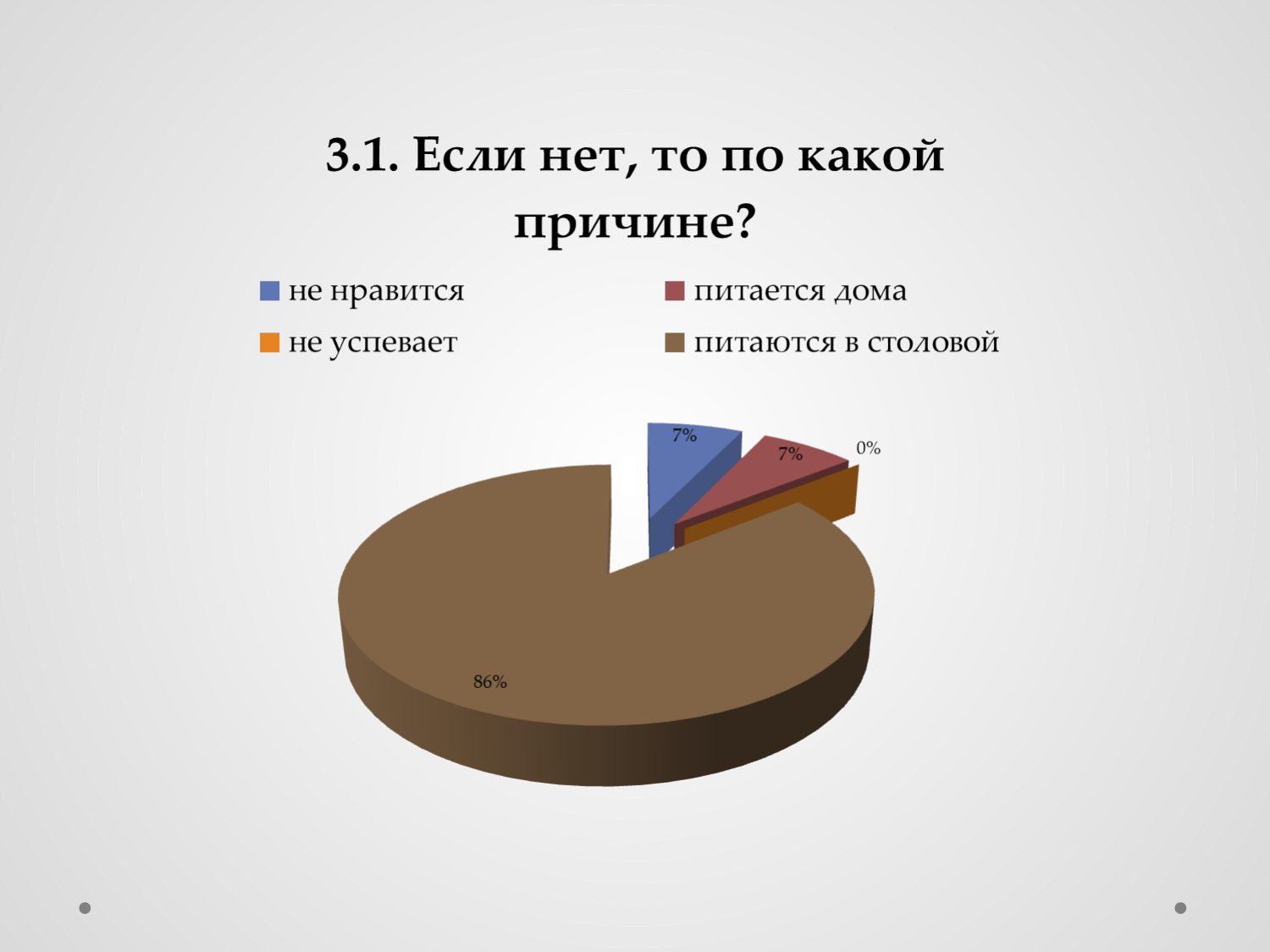
What is the title of the chart? 3.1. Если нет, то по какой причине? What share of the pie is labelled for "питается дома"? 7% What kind of chart is shown on the slide? pie chart Which is larger, the share for "питаются в столовой" or the share for "питается дома"? питаются в столовой What share of the pie is labelled for "питаются в столовой"? 86% What is the difference between the shares for "питаются в столовой" and "не нравится"? 79% What share of the pie is labelled for "не успевает"? 0% Which category has the largest slice of the pie? питаются в столовой How many entries does the legend list? 4 What colour is the slice for "не нравится"? blue Which category has the smallest slice of the pie? не успевает